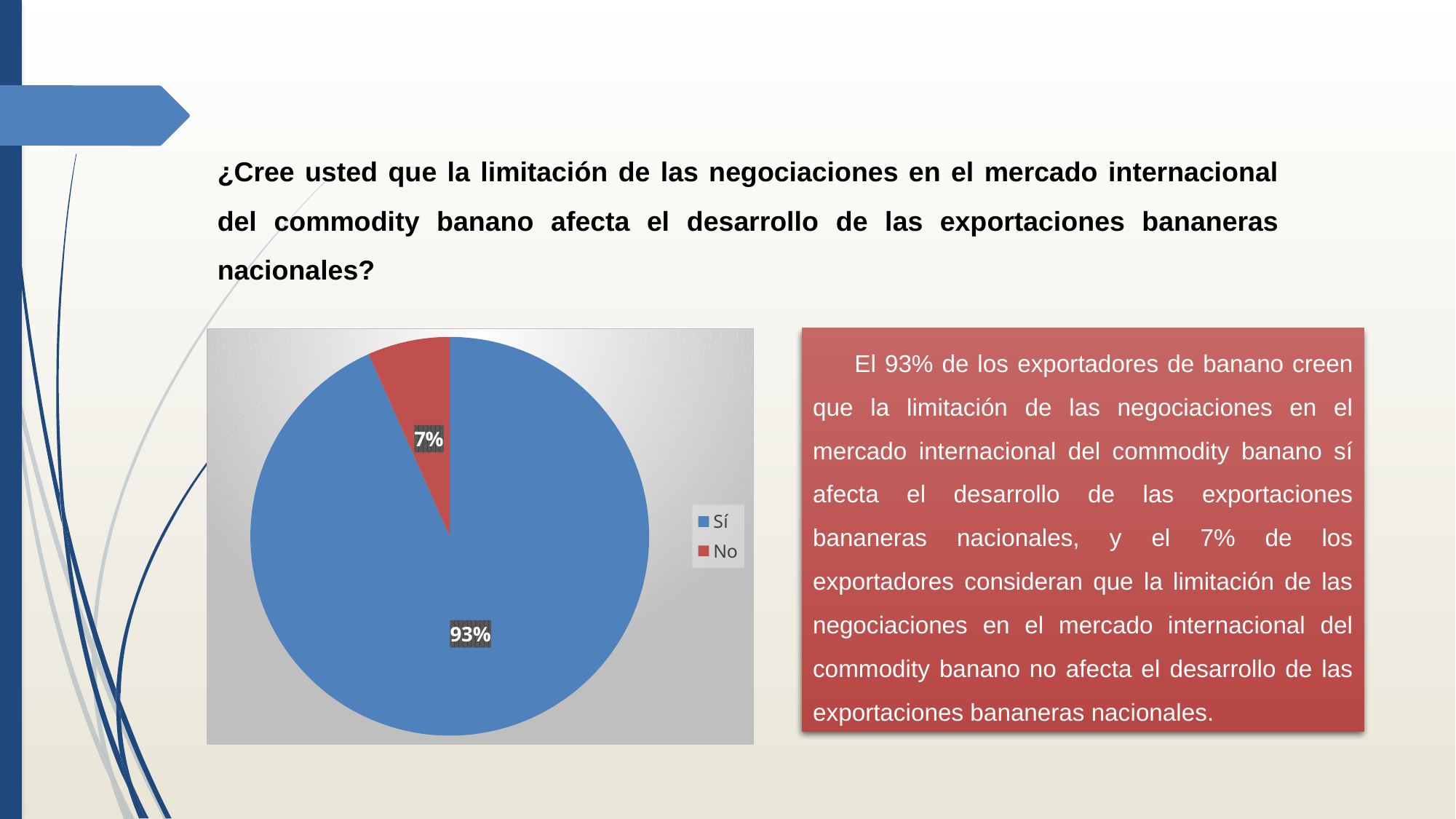
What colour is the "Sí" slice in the pie chart? blue What colour is the "No" slice in the pie chart? red What is the difference in percentage points between the "Sí" and "No" slices? 86 Which slice is larger, "Sí" or "No"? Sí Which category has the largest slice of the pie? Sí Which category has the smallest slice of the pie? No What kind of chart is shown on the slide? pie chart What share of the pie does the "Sí" slice represent? 93% How many entries does the legend list? 2 How many slices does the pie chart have? 2 What share of the pie does the "No" slice represent? 7%